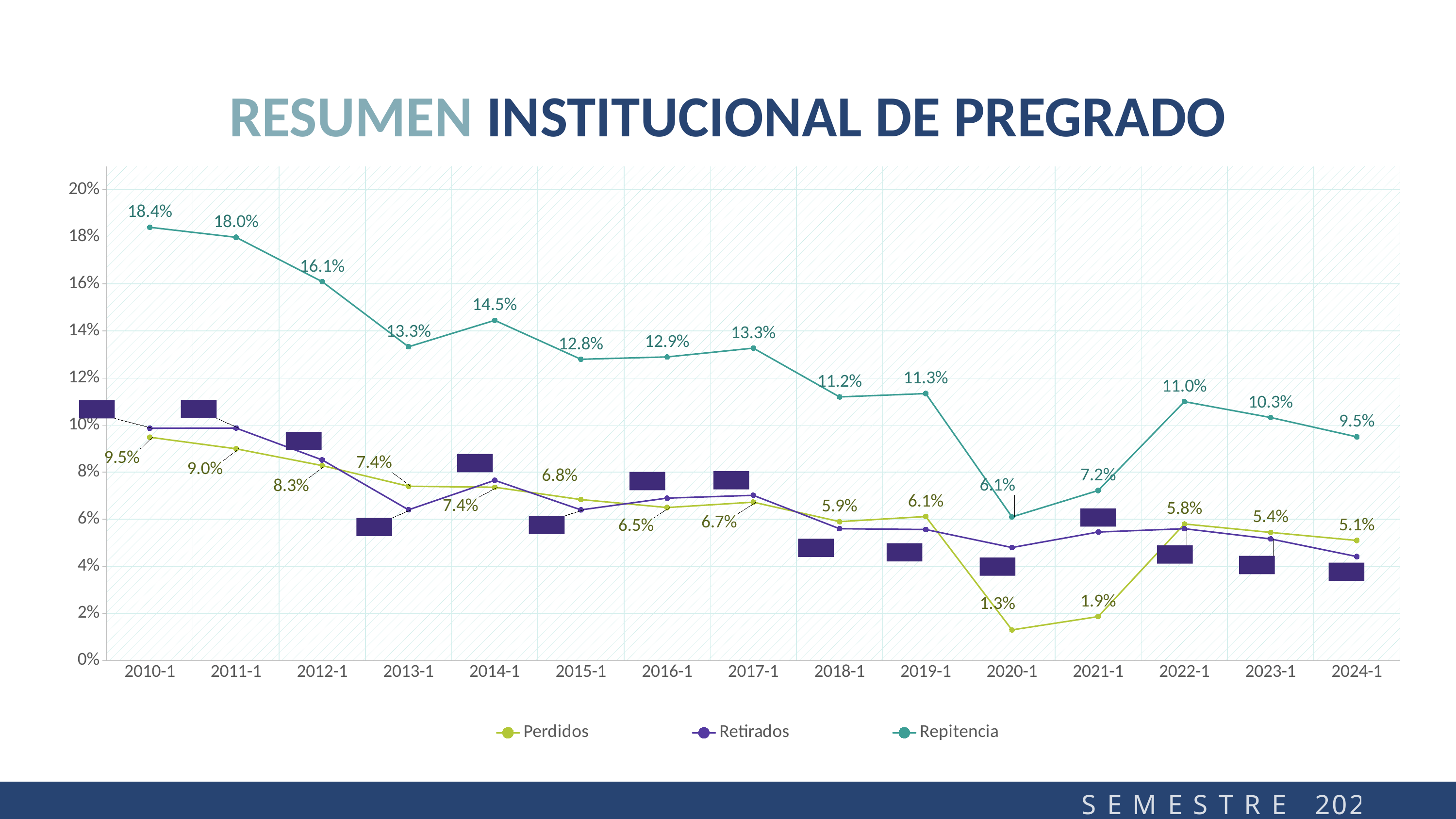
In which period is the Repitencia series at its lowest? 2020-1 Is the Retirados value for 2011-1 greater or less than 8%? greater What is the Repitencia value for 2024-1? 9.5% What kind of chart is shown on the slide? line chart How many series does the legend list? 3 What is the Perdidos value for 2020-1? 1.3% Is the Retirados value for 2020-1 greater or less than 6%? less What is the difference between the Repitencia values for 2010-1 and 2024-1? 8.9% Which is larger, the Perdidos value for 2022-1 or for 2023-1? 2022-1 What is the Repitencia value for 2010-1? 18.4% In which period is the Perdidos series at its highest? 2010-1 How many periods are shown on the x axis? 15